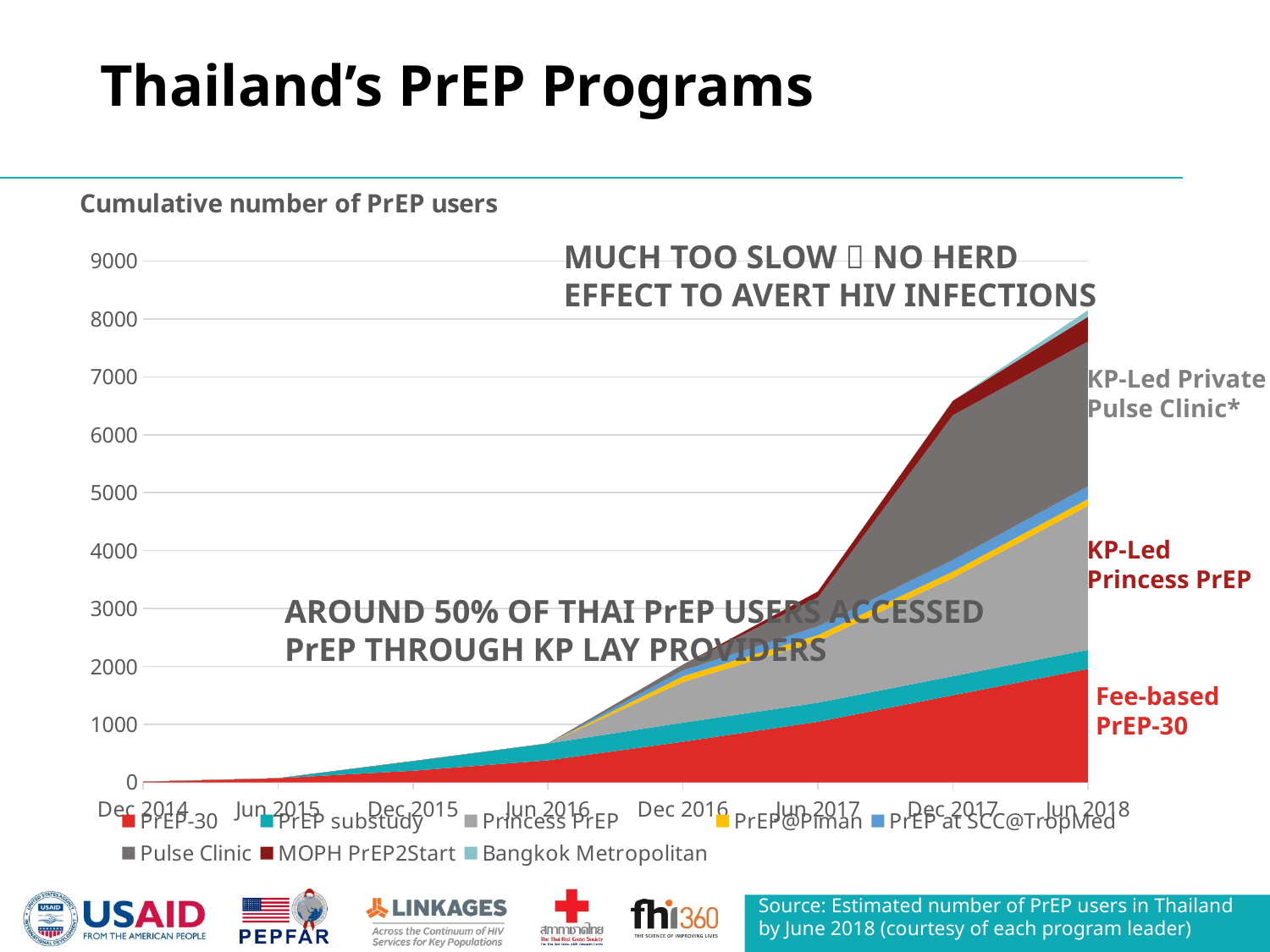
Which is larger, the total cumulative number of PrEP users at Jun 2018 or at Dec 2017? Jun 2018 What kind of chart is shown on the slide? Stacked area chart How many series does the chart's legend list? 8 What is the title of the chart? Cumulative number of PrEP users At which labelled time point is the cumulative number of PrEP users lowest? Dec 2014 Is the total cumulative number of PrEP users at Jun 2018 greater or less than 7000? greater How many time points are labelled on the x axis of the chart? 8 At which labelled time point is the cumulative number of PrEP users highest? Jun 2018 Is the total cumulative number of PrEP users at Jun 2017 greater or less than 2000? greater Does the cumulative number of PrEP users rise or fall from Dec 2014 to Jun 2018? Rises What is the highest value labelled on the y axis of the chart? 9000 Is the total cumulative number of PrEP users at Dec 2017 greater or less than 6000? greater